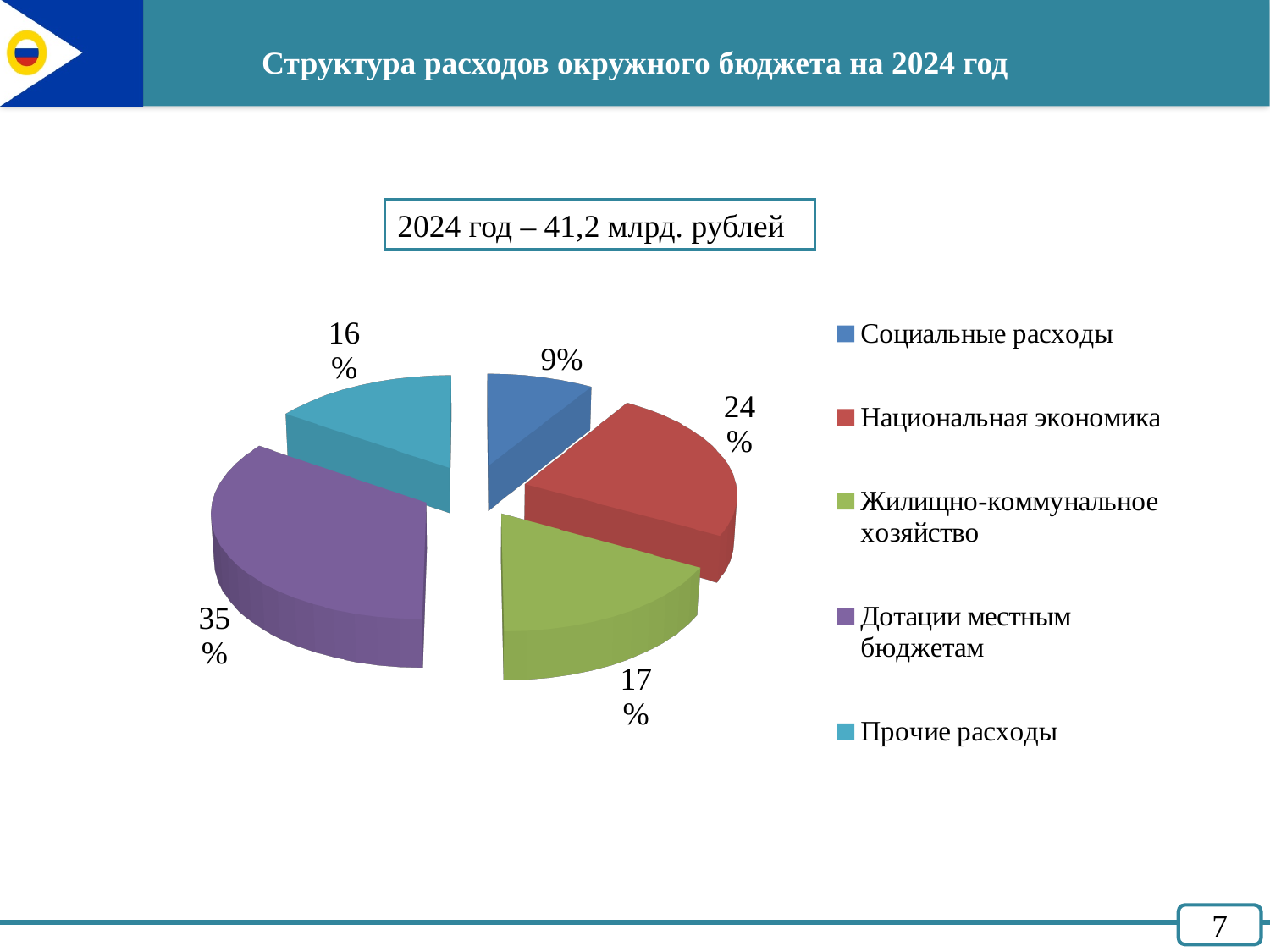
Which is larger, the share for Жилищно-коммунальное хозяйство or the share for Прочие расходы? Жилищно-коммунальное хозяйство What total amount for 2024 is stated in the box above the chart? 41,2 млрд. рублей What share of the pie does Прочие расходы take? 16% What share of the pie does Социальные расходы take? 9% What share of the pie does Национальная экономика take? 24% What kind of chart is shown on the slide? Pie chart What is the difference in percentage points between Дотации местным бюджетам and Национальная экономика? 11 Which category has the largest slice of the pie? Дотации местным бюджетам Which category has the smallest slice of the pie? Социальные расходы How many categories does the legend list? 5